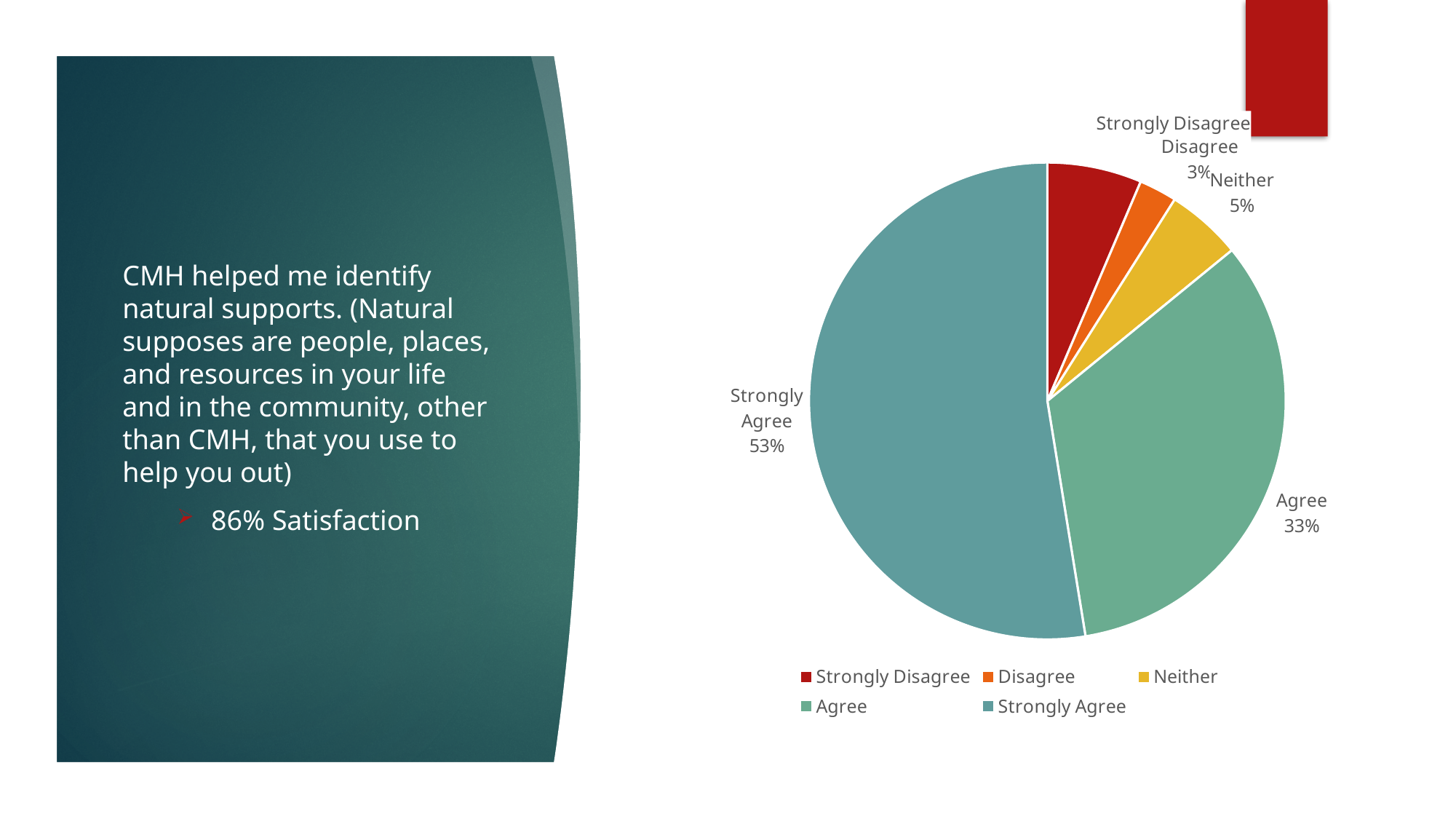
Which slice is larger, Agree or Neither? Agree Which category has the largest slice in the pie chart? Strongly Agree How many entries does the legend of the pie chart list? 5 What percentage of the pie chart is Strongly Agree? 53% What percentage of the pie chart is Neither? 5% Which slice is larger, Strongly Disagree or Disagree? Strongly Disagree What is the difference in percentage points between Strongly Agree and Agree? 20 percentage points What kind of chart is shown on the slide? Pie chart Which category has the smallest slice in the pie chart? Disagree How many categories does the pie chart have? 5 What is the combined percentage of the Agree and Strongly Agree slices? 86% What percentage of the pie chart is Agree? 33%